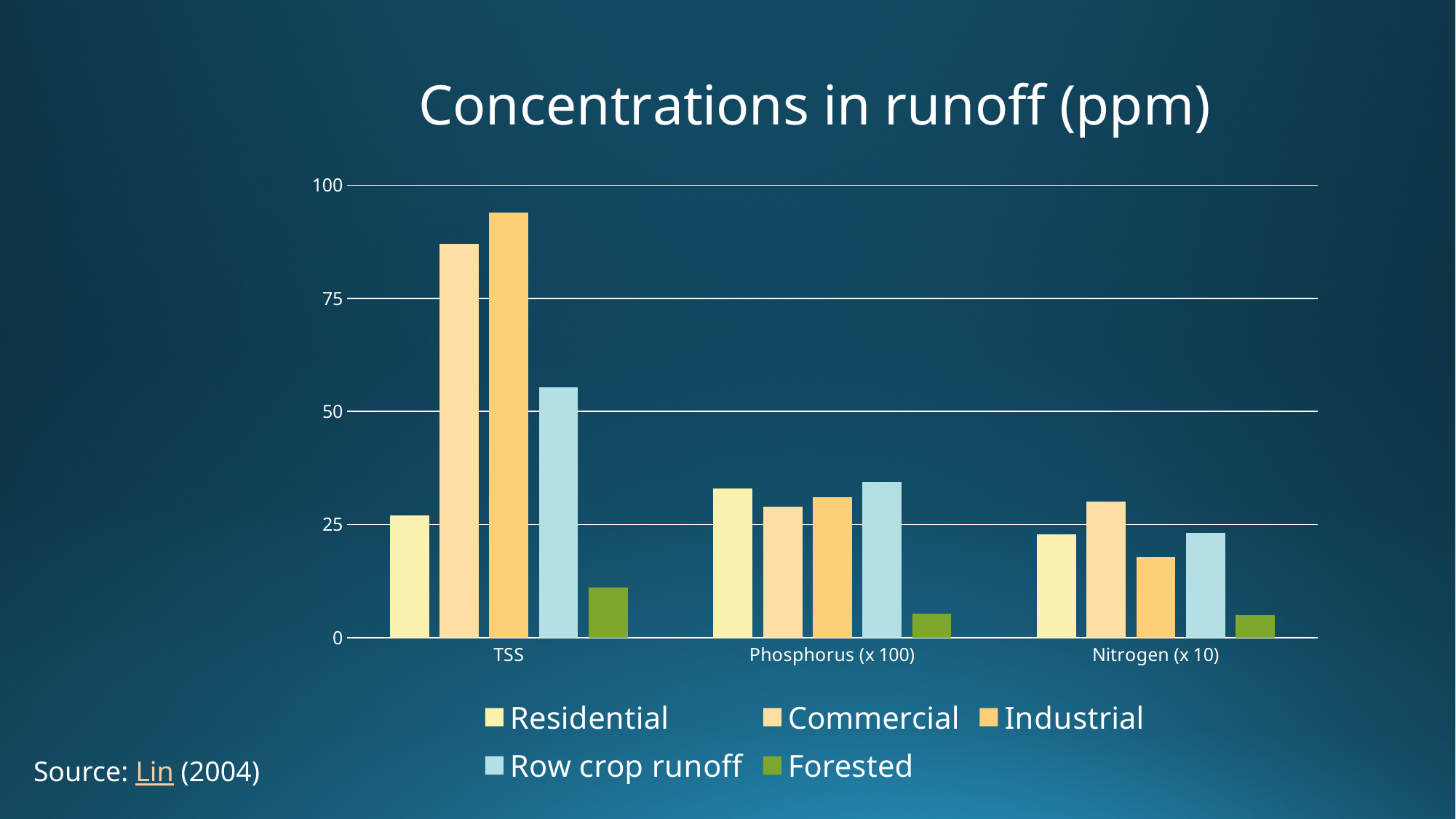
For TSS, which is larger: the Commercial value or the Row crop runoff value? Commercial Which series has the highest value for TSS? Industrial Is the Industrial value for Nitrogen (x 10) greater or less than 25? less Which series has the highest value for Nitrogen (x 10)? Commercial How many categories are shown on the x axis? 3 What kind of chart is shown on the slide? bar chart Which series has the lowest value for TSS? Forested What is the title of the chart? Concentrations in runoff (ppm) Which series has the lowest value for Phosphorus (x 100)? Forested Is the Commercial value for TSS greater or less than 75? greater How many series does the legend list? 5 Which series is shown in green in the legend? Forested